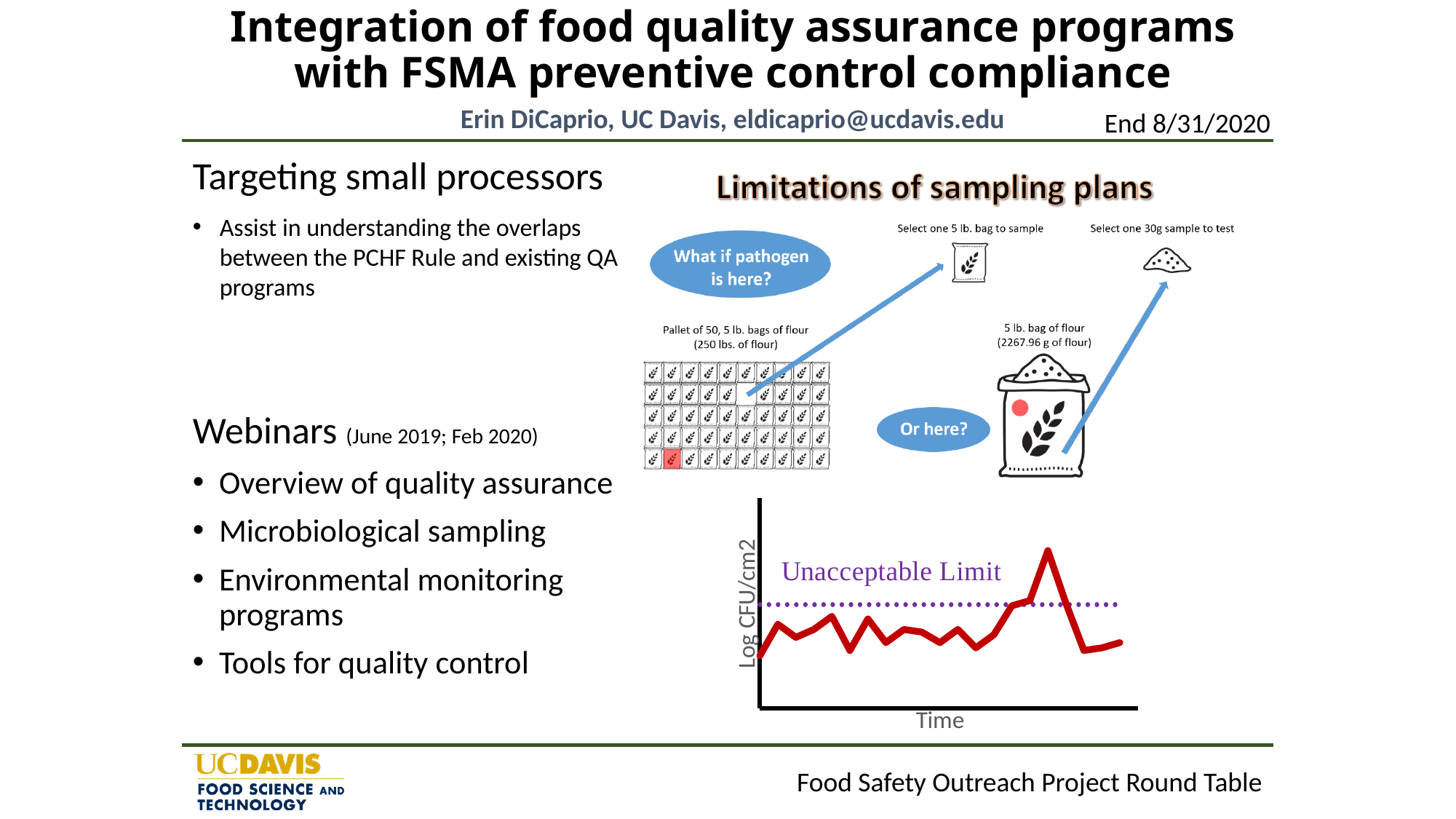
In the bottom-right chart, is the final value of the red line above or below the Unacceptable Limit? Below In the bottom-right chart, is the peak of the red line above or below the Unacceptable Limit? Above In the bottom-right chart, how many times does the red line rise above the Unacceptable Limit? Once What is the label on the y-axis of the line chart at the bottom right? Log CFU/cm2 In the bottom-right chart, is the first value of the red line above or below the Unacceptable Limit? Below What kind of chart is shown at the bottom right of the slide? Line chart What does the dotted purple line in the bottom-right chart represent? Unacceptable Limit